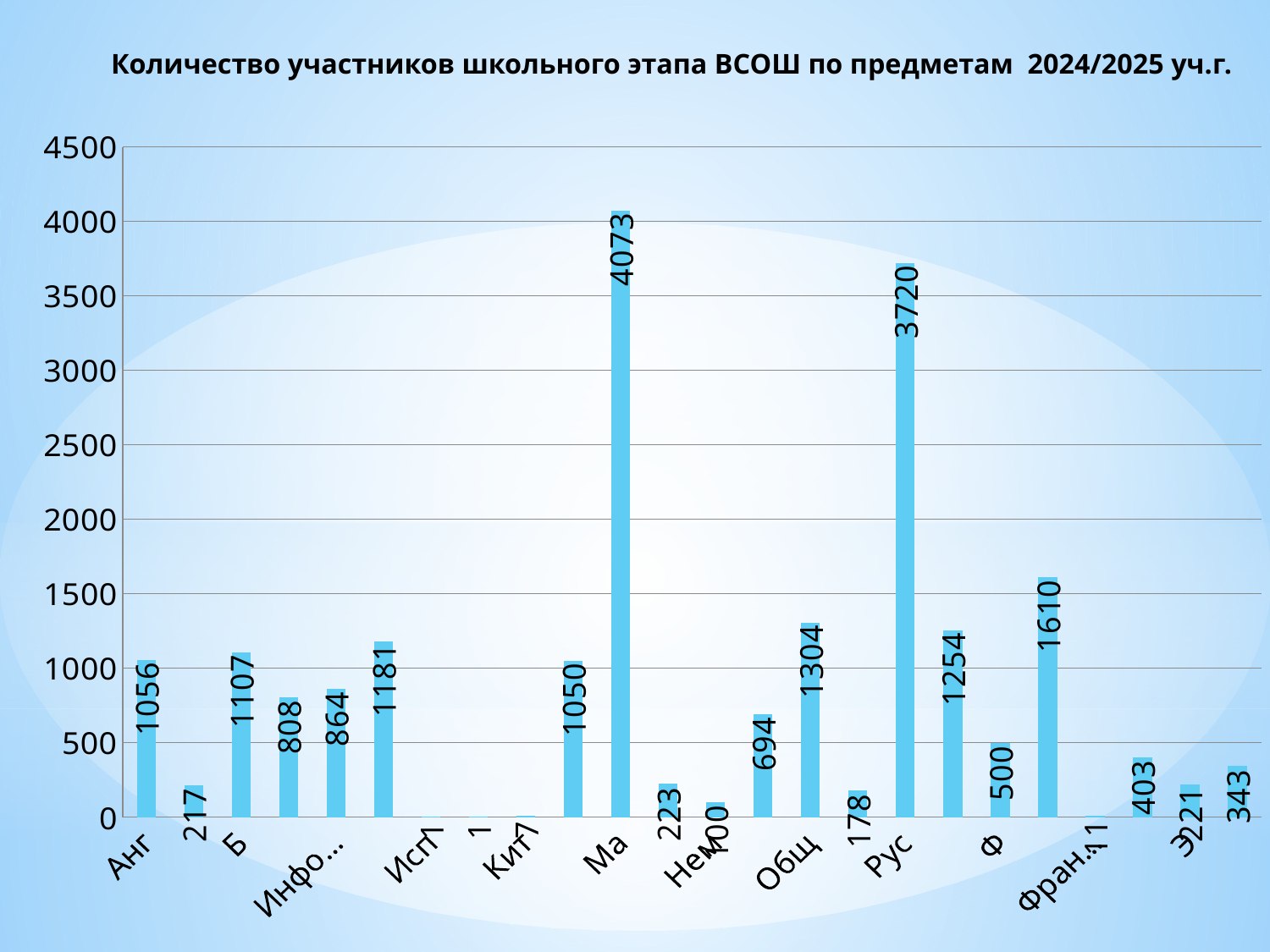
What is the value for Ф? 500 Which category has the highest value? Ма Is the value for Б greater or less than 1000? greater What is the difference between the values for Ма and Рус? 353 What is the value for Анг? 1056 What is the title of the chart? Количество участников школьного этапа ВСОШ по предметам 2024/2025 уч.г. Is the value for Нем greater or less than 500? less What is the value for Рус? 3720 Which is larger, the value for Общ or the value for Анг? Общ What is the value for Общ? 1304 What is the value for Ма? 4073 What type of chart is shown on the slide? bar chart